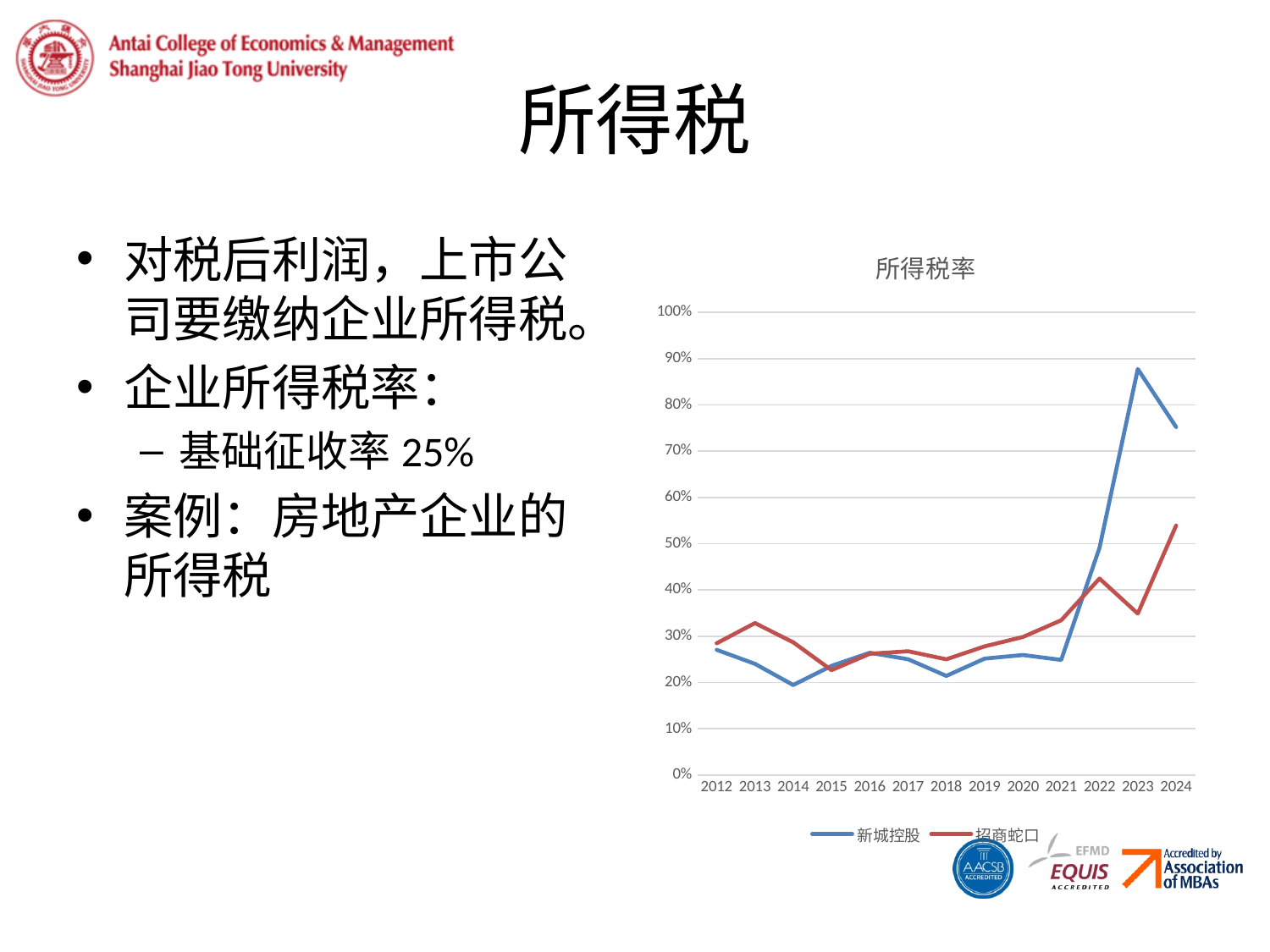
How many years are shown on the x axis of the chart? 13 Is the value for 新城控股 in 2023 greater or less than 80%? greater In which year does 新城控股 reach its lowest value? 2014 What kind of chart is shown on the slide? line chart How many series does the chart's legend list? 2 Is the value for 招商蛇口 in 2024 greater or less than 50%? greater Is the value for 招商蛇口 in 2023 greater or less than 40%? less What is the title of the chart? 所得税率 In which year does 招商蛇口 reach its highest value? 2024 In 2023, which series has the larger value, 新城控股 or 招商蛇口? 新城控股 In which year does 新城控股 reach its highest value? 2023 Which series is drawn in blue in the chart? 新城控股